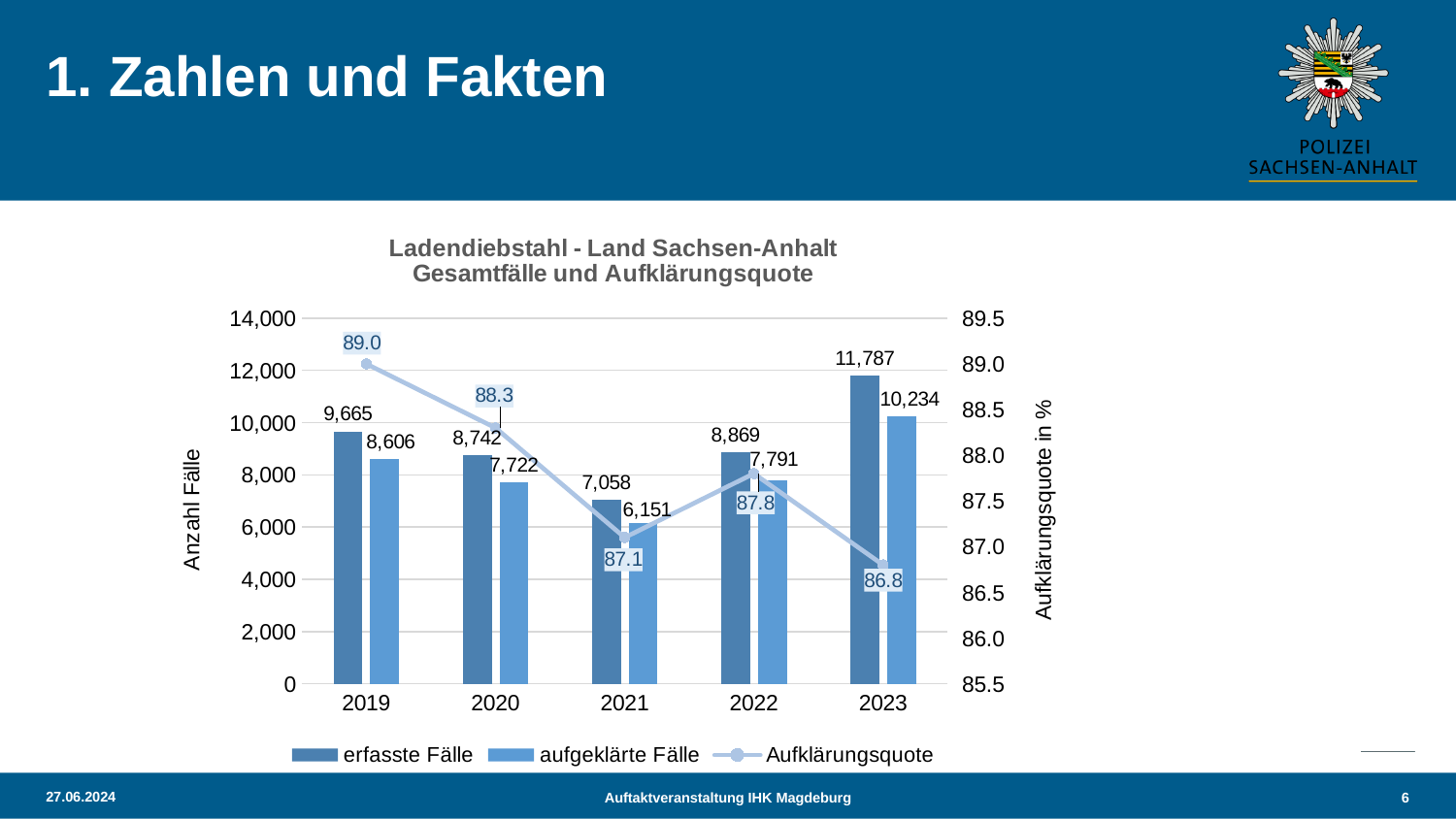
What is the value of aufgeklärte Fälle for 2021? 6,151 How many years are shown on the x axis? 5 What is the title of the chart? Ladendiebstahl - Land Sachsen-Anhalt Gesamtfälle und Aufklärungsquote How many series does the legend list? 3 What is the difference between erfasste Fälle and aufgeklärte Fälle in 2020? 1,020 What is the Aufklärungsquote for 2019? 89.0 Which is larger: aufgeklärte Fälle in 2019 or aufgeklärte Fälle in 2022? aufgeklärte Fälle in 2019 What is the value of erfasste Fälle for 2023? 11,787 Which year has the lowest Aufklärungsquote? 2023 Which year has the highest value of erfasste Fälle? 2023 Does the Aufklärungsquote rise or fall from 2019 to 2021? fall What kind of chart is this? Combined bar and line chart